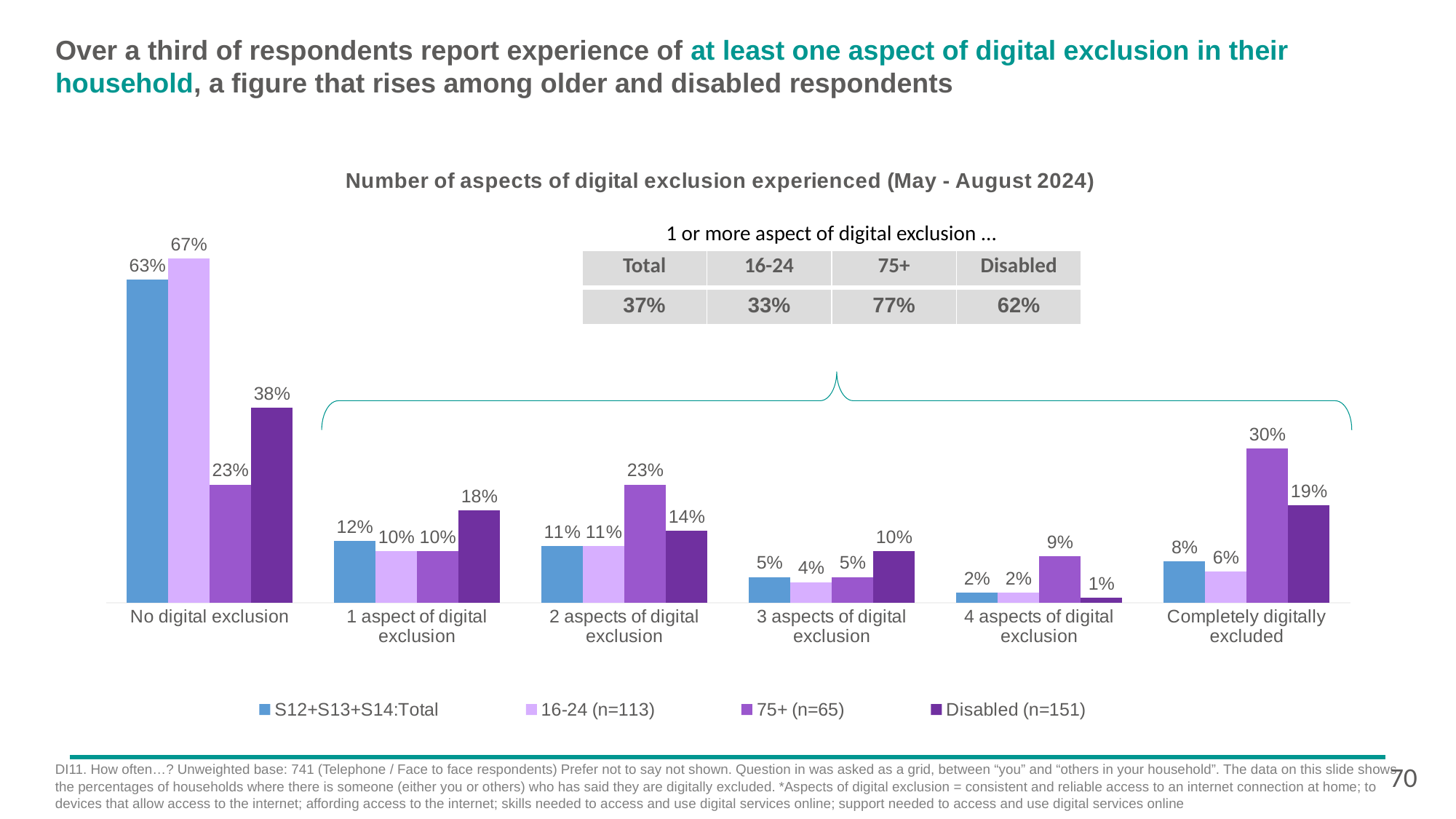
What is the value for the Disabled (n=151) series in the '1 aspect of digital exclusion' category? 18% What kind of chart is shown on the slide? Bar chart According to the table on the slide, what percentage of 75+ respondents report 1 or more aspect of digital exclusion? 77% Which series has the lowest value in the '4 aspects of digital exclusion' category? Disabled (n=151) What is the title of the chart? Number of aspects of digital exclusion experienced (May - August 2024) Which series has the highest value in the '2 aspects of digital exclusion' category? 75+ (n=65) How many categories are shown on the x axis of the chart? 6 In the '3 aspects of digital exclusion' category, which is larger: the Disabled (n=151) value or the 75+ (n=65) value? Disabled (n=151) How many series does the chart legend list? 4 What is the value for the 16-24 (n=113) series in the 'No digital exclusion' category? 67% What is the difference between the 16-24 (n=113) and Disabled (n=151) values in the 'No digital exclusion' category? 29% What is the value for the 75+ (n=65) series in the 'Completely digitally excluded' category? 30%